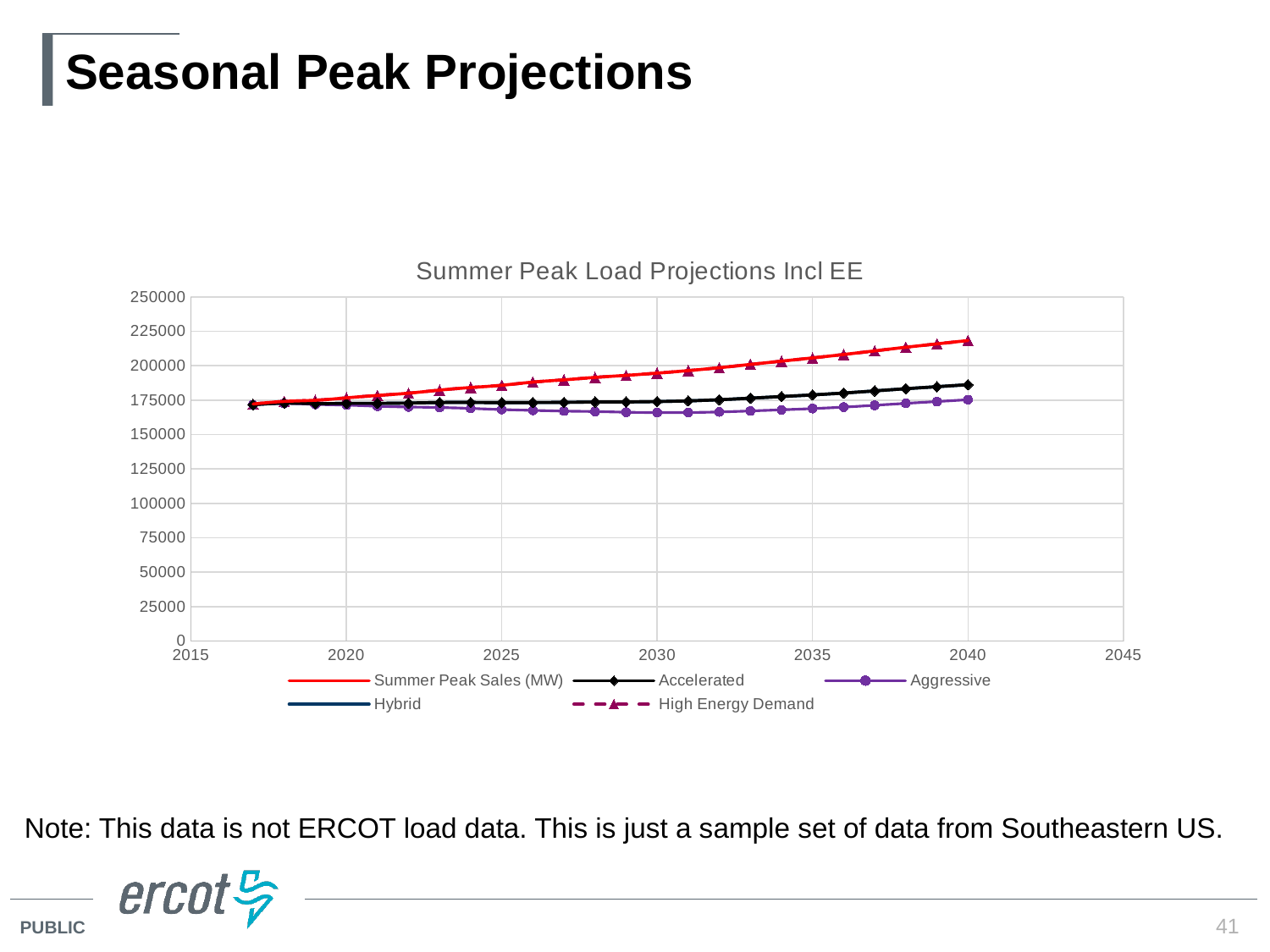
In 2040, which is larger: Summer Peak Sales (MW) or Accelerated? Summer Peak Sales (MW) Is the value for Accelerated in 2040 greater or less than 200000? less Is the value for Summer Peak Sales (MW) in 2020 greater or less than 200000? less How many series does the legend list? 5 In 2035, which is larger: Accelerated or Aggressive? Accelerated What is the title of the chart? Summer Peak Load Projections Incl EE Is the value for Aggressive in 2030 greater or less than 175000? less Does the Summer Peak Sales (MW) line rise or fall from 2017 to 2040? rise What kind of chart is shown on the slide? line chart What is the highest value shown on the y axis? 250000